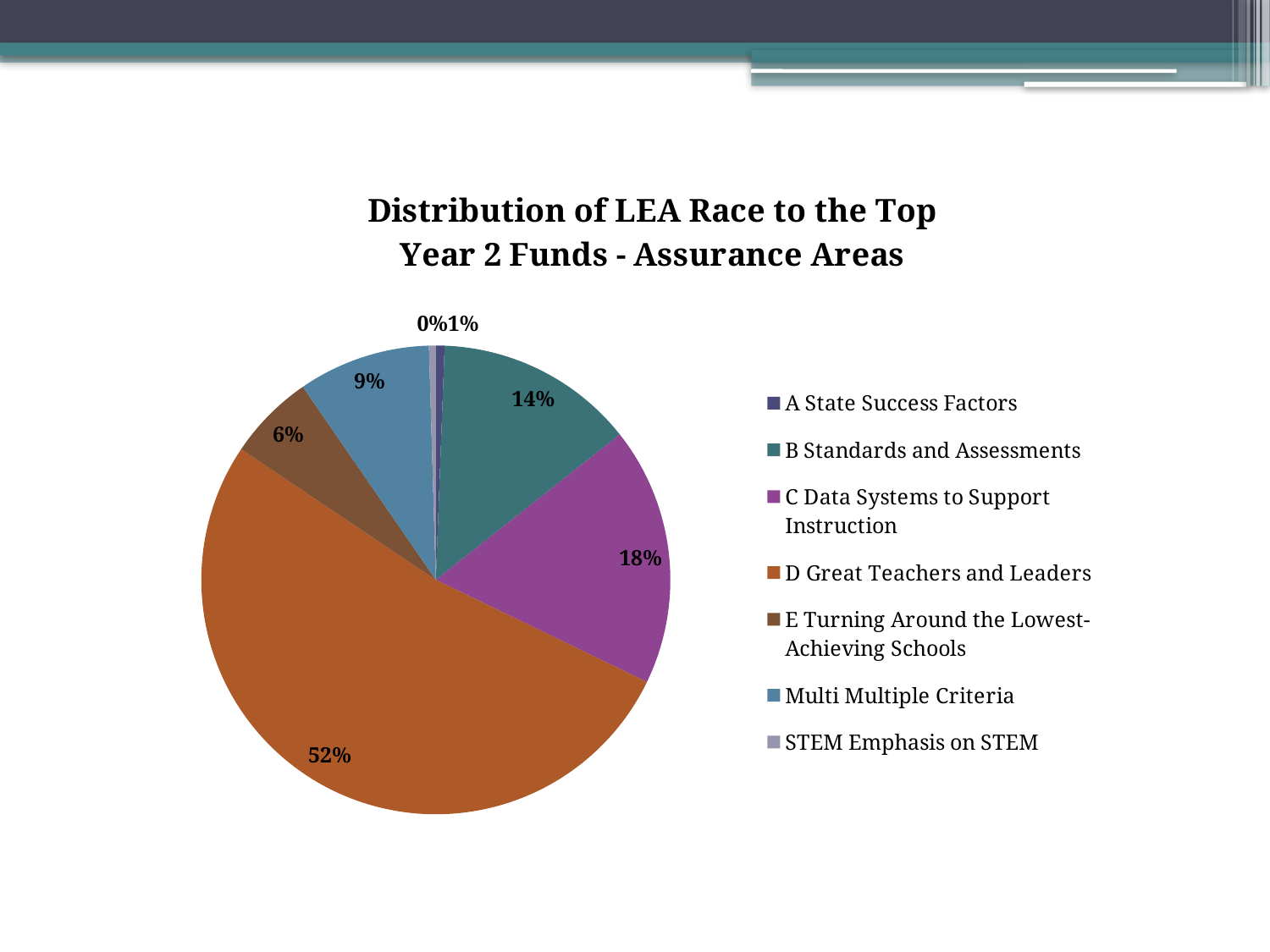
Which is larger: the share for B Standards and Assessments or C Data Systems to Support Instruction? C Data Systems to Support Instruction What percentage of the pie is C Data Systems to Support Instruction? 18% How many percentage points larger is the share for Multi Multiple Criteria than for E Turning Around the Lowest-Achieving Schools? 3 percentage points How many percentage points larger is the share for D Great Teachers and Leaders than for C Data Systems to Support Instruction? 34 percentage points Which assurance area has the largest share of the pie? D Great Teachers and Leaders What percentage of the pie is B Standards and Assessments? 14% What percentage of the pie is D Great Teachers and Leaders? 52% What percentage of the pie is Multi Multiple Criteria? 9% What is the title of the chart? Distribution of LEA Race to the Top Year 2 Funds - Assurance Areas What kind of chart is shown on the slide? Pie chart What percentage of the pie is E Turning Around the Lowest-Achieving Schools? 6% How many categories does the legend list? 7